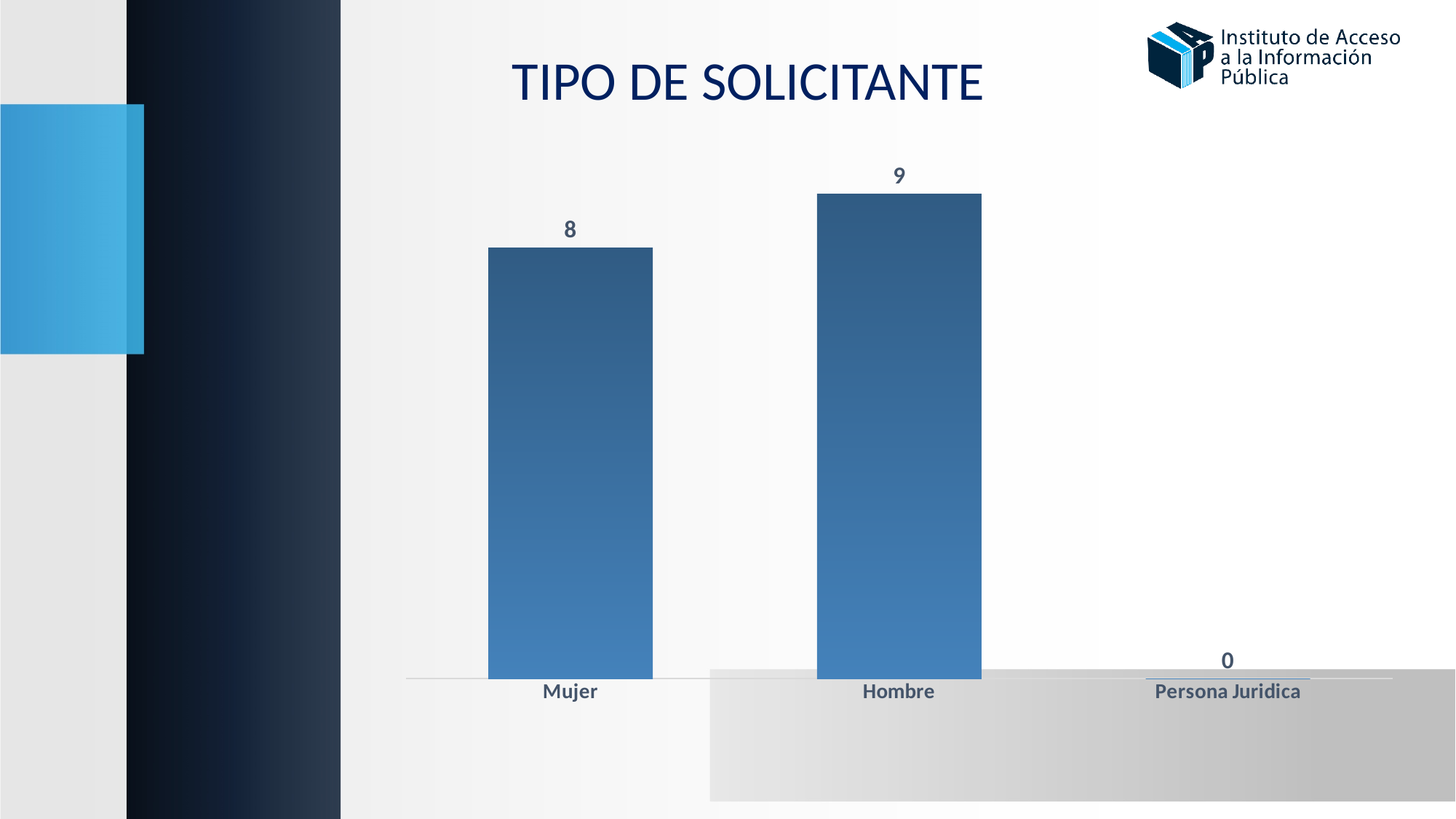
What is the value for Persona Juridica? 0 What is the total of the values for Mujer, Hombre and Persona Juridica? 17 Which is larger, the value for Mujer or the value for Hombre? Hombre What is the difference between the values for Mujer and Persona Juridica? 8 Which category has the highest value? Hombre Which category has the lowest value? Persona Juridica What is the value for Mujer? 8 What is the title of the chart? TIPO DE SOLICITANTE How many categories are shown on the x axis? 3 What is the difference between the values for Hombre and Mujer? 1 What kind of chart is shown on the slide? Bar chart What is the value for Hombre? 9